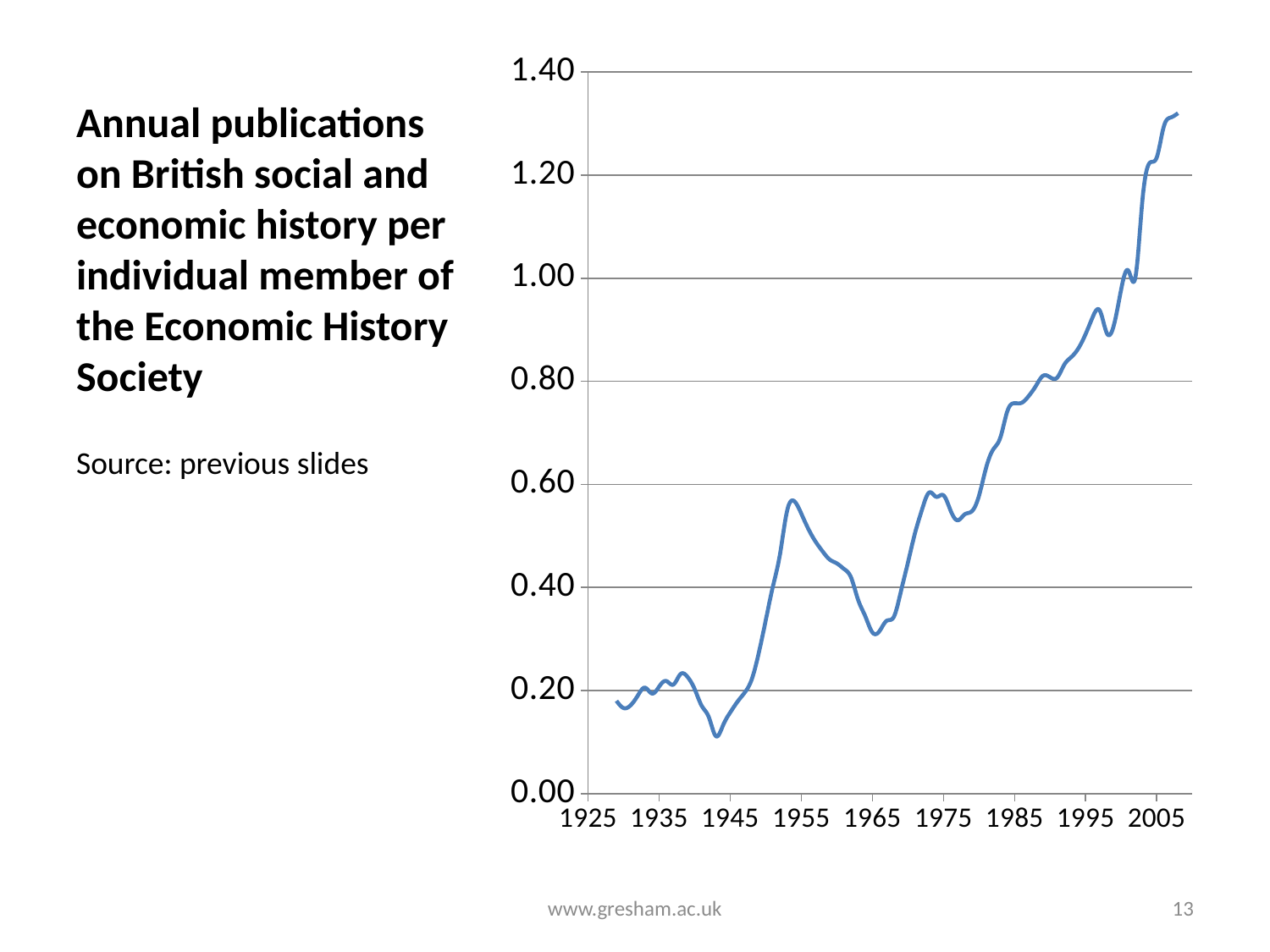
Is the value for 1965 greater or less than 0.40? less What kind of chart is shown on the slide? line chart Is the value for 1995 greater or less than 0.80? greater Is the value for 2005 greater or less than 1.20? greater Between 1955 and 1965, do the values rise or fall? fall How many lines are plotted on the chart? 1 Overall, do the values rise or fall from 1925 to 2005? rise Which is larger, the value for 2005 or the value for 1955? 2005 What is the highest value shown on the vertical axis? 1.40